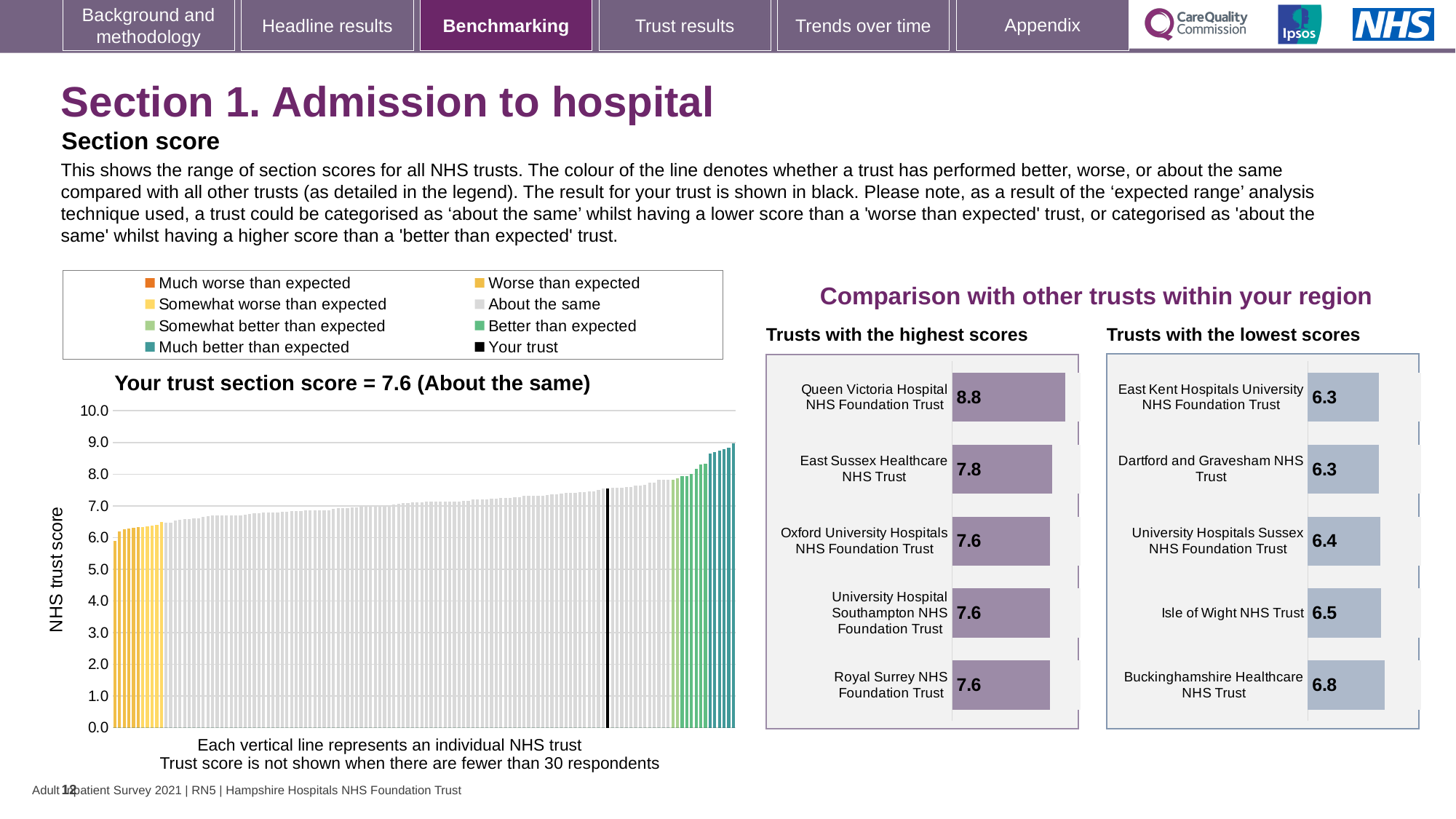
What kind of chart is the 'Your trust section score' chart? bar chart What is the y-axis label of the 'Your trust section score' chart? NHS trust score In the 'Trusts with the highest scores' chart, which trust has the highest score? Queen Victoria Hospital NHS Foundation Trust In the 'Your trust section score' chart, do the trust scores rise or fall from left to right? rise How many entries does the legend above the 'Your trust section score' chart list? 8 In the 'Trusts with the lowest scores' chart, which trust has the highest score? Buckinghamshire Healthcare NHS Trust In the 'Trusts with the highest scores' chart, what is the score for Queen Victoria Hospital NHS Foundation Trust? 8.8 In the 'Trusts with the lowest scores' chart, what is the difference between the scores of Buckinghamshire Healthcare NHS Trust and Dartford and Gravesham NHS Trust? 0.5 In the 'Trusts with the highest scores' chart, what is the difference between the scores of Queen Victoria Hospital NHS Foundation Trust and East Sussex Healthcare NHS Trust? 1.0 In the 'Your trust section score' chart, what is the section score for your trust? 7.6 How many trusts are shown in the 'Trusts with the highest scores' chart? 5 In the 'Trusts with the lowest scores' chart, what is the score for Isle of Wight NHS Trust? 6.5